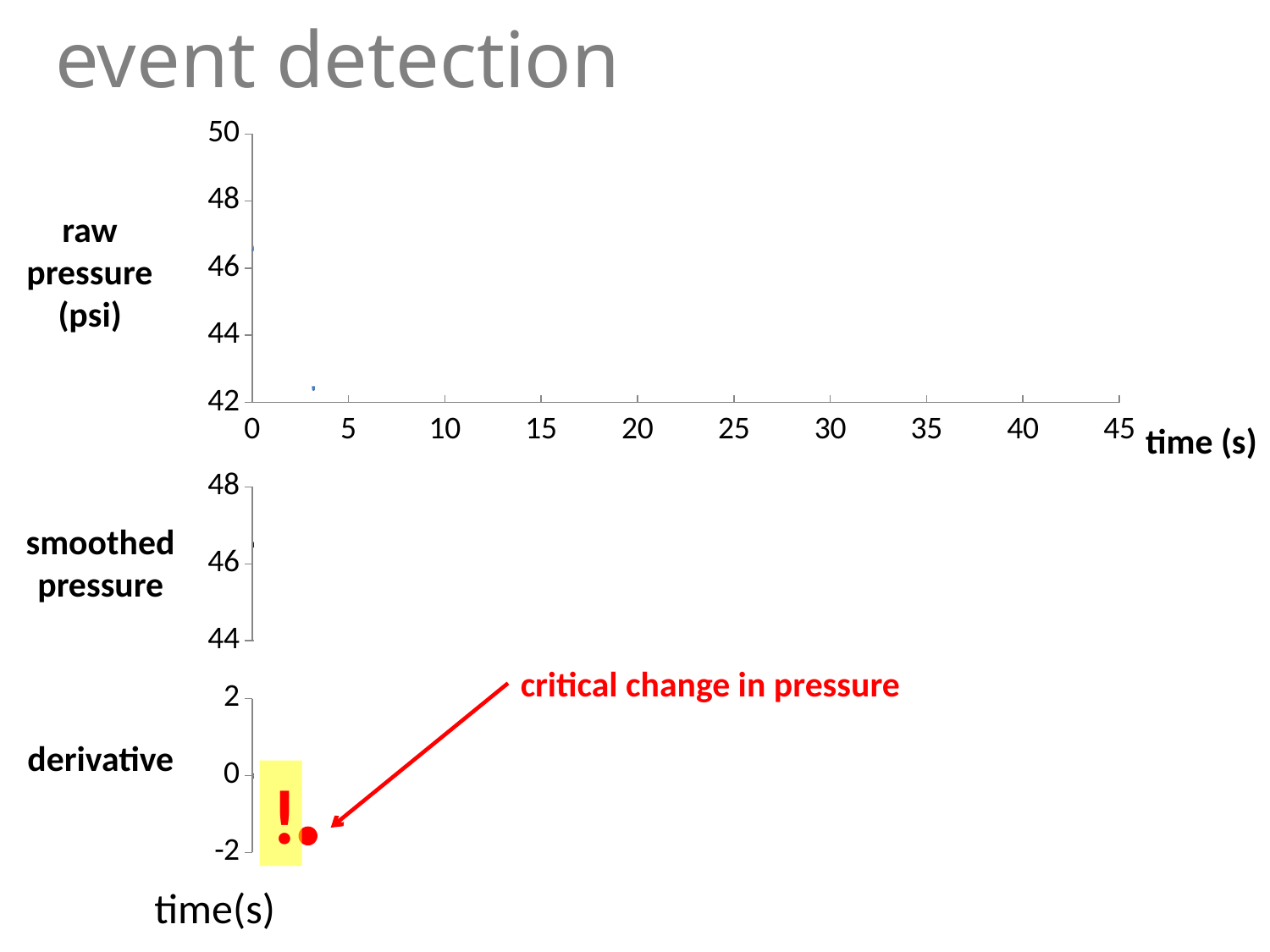
What does the red annotation on the derivative chart say the highlighted point indicates? critical change in pressure On the raw pressure (psi) chart, is the plotted value near time 3 greater or less than 44? less What is the highest tick value on the y axis of the raw pressure (psi) chart? 50 On the raw pressure (psi) chart, is the plotted value at time 0 greater or less than 46? greater On the smoothed pressure chart, is the plotted value at time 0 greater or less than 46? greater